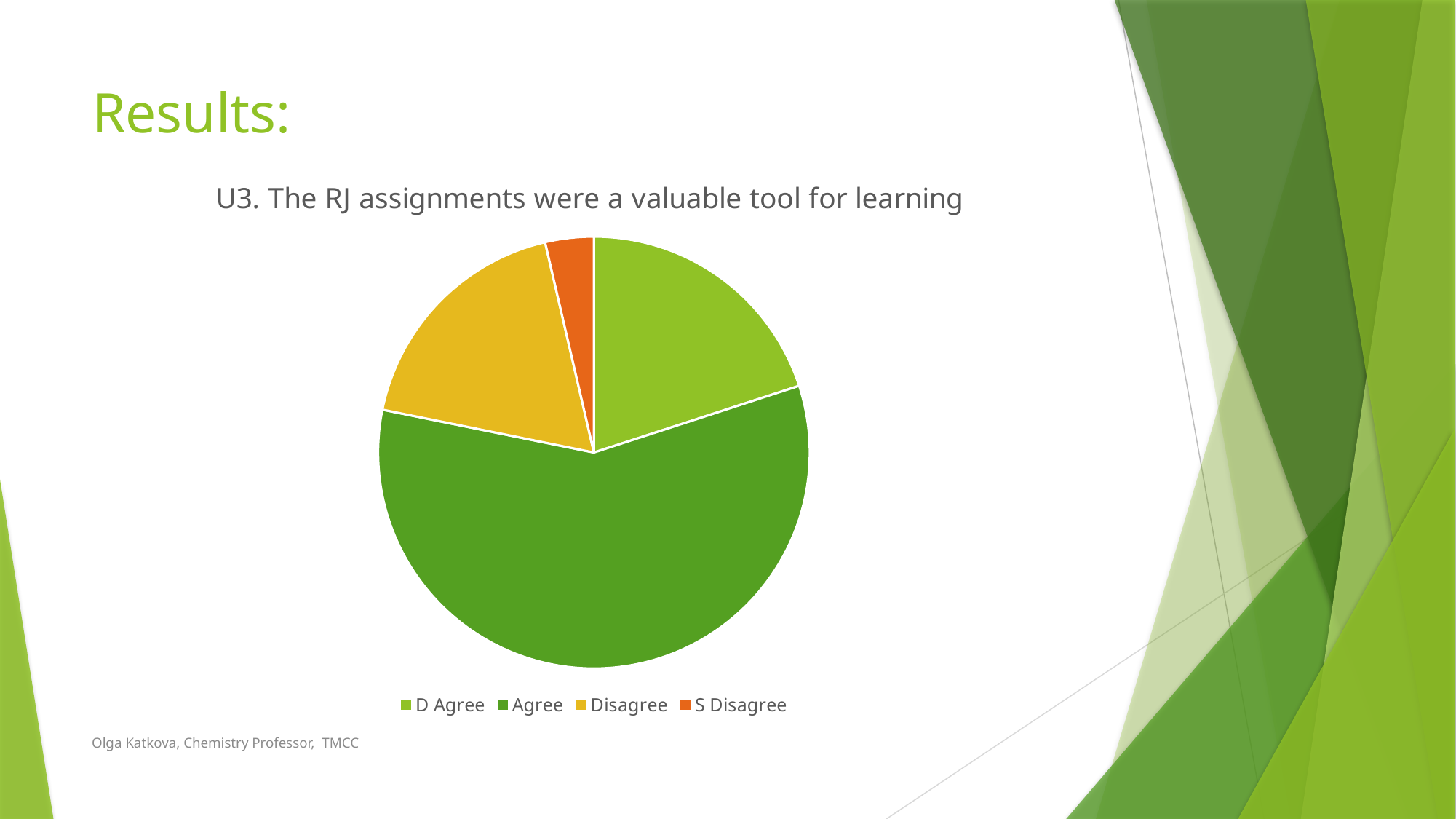
What kind of chart is shown on the slide? pie chart What colour is the S Disagree slice in the pie chart? orange Which slice is larger, Agree or Disagree? Agree How many categories (slices) does the pie chart have? 4 Which slice is larger, Agree or D Agree? Agree What is the title of the chart? U3. The RJ assignments were a valuable tool for learning Which category has the smallest slice of the pie? S Disagree How many entries does the chart legend list? 4 Which category has the largest slice of the pie? Agree Which slice is larger, D Agree or S Disagree? D Agree